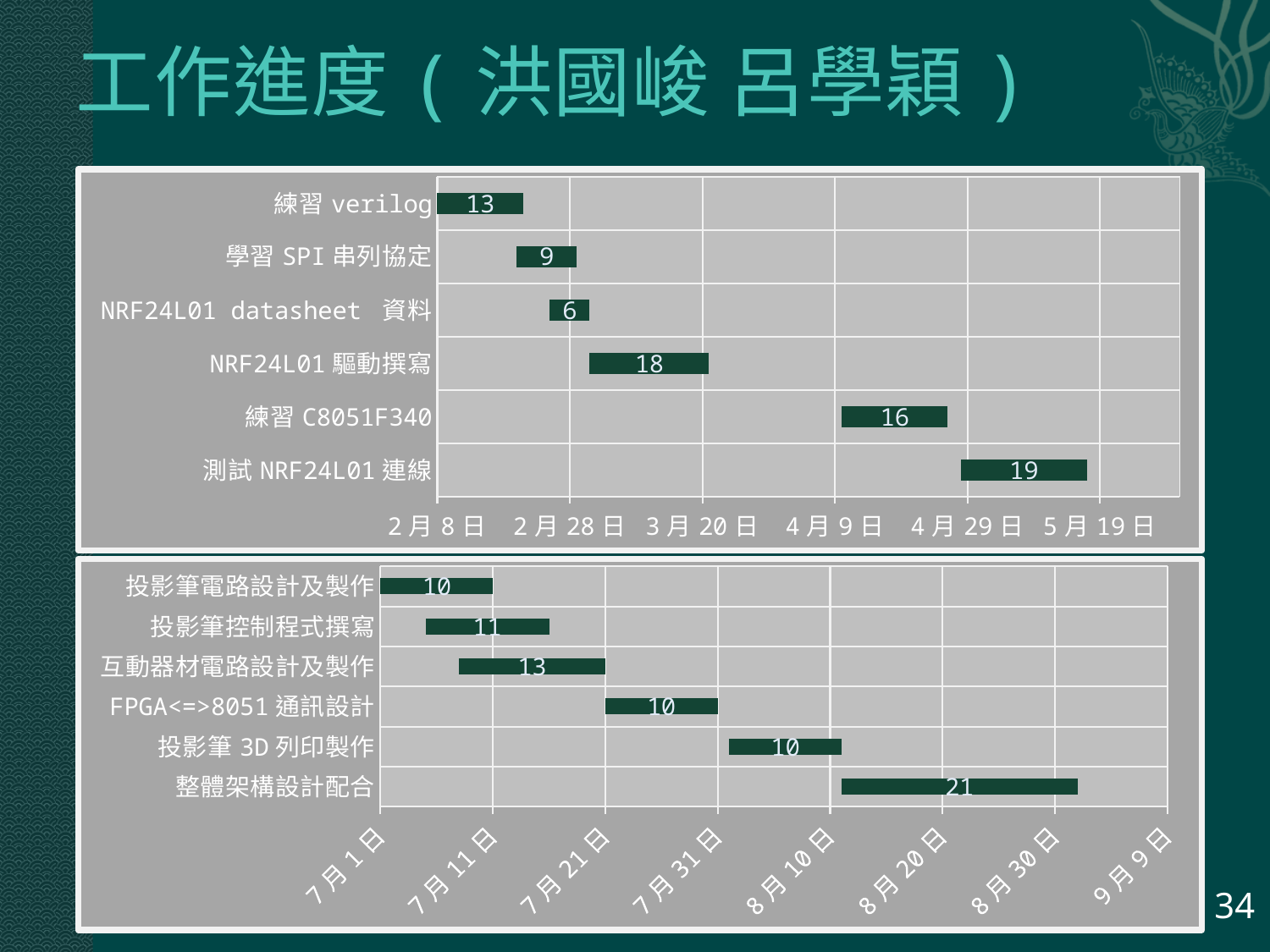
In the bottom chart, what is the difference between the values for 整體架構設計配合 and 投影筆 3D 列印製作? 11 What kind of chart is the bottom chart? bar chart In the bottom chart, what is the value shown for 整體架構設計配合? 21 In the top chart, how many tasks are listed? 6 In the bottom chart, which is larger, the value for 投影筆控制程式撰寫 or the value for 投影筆電路設計及製作? 投影筆控制程式撰寫 In the bottom chart, which task has the highest value? 整體架構設計配合 In the top chart, what is the value shown for 練習 verilog? 13 In the top chart, what is the difference between the values for 測試 NRF24L01 連線 and 練習 C8051F340? 3 In the bottom chart, what is the value shown for 互動器材電路設計及製作? 13 In the top chart, which task has the lowest value? NRF24L01 datasheet 資料 In the top chart, which task has the highest value? 測試 NRF24L01 連線 In the top chart, what is the value shown for NRF24L01 驅動撰寫? 18